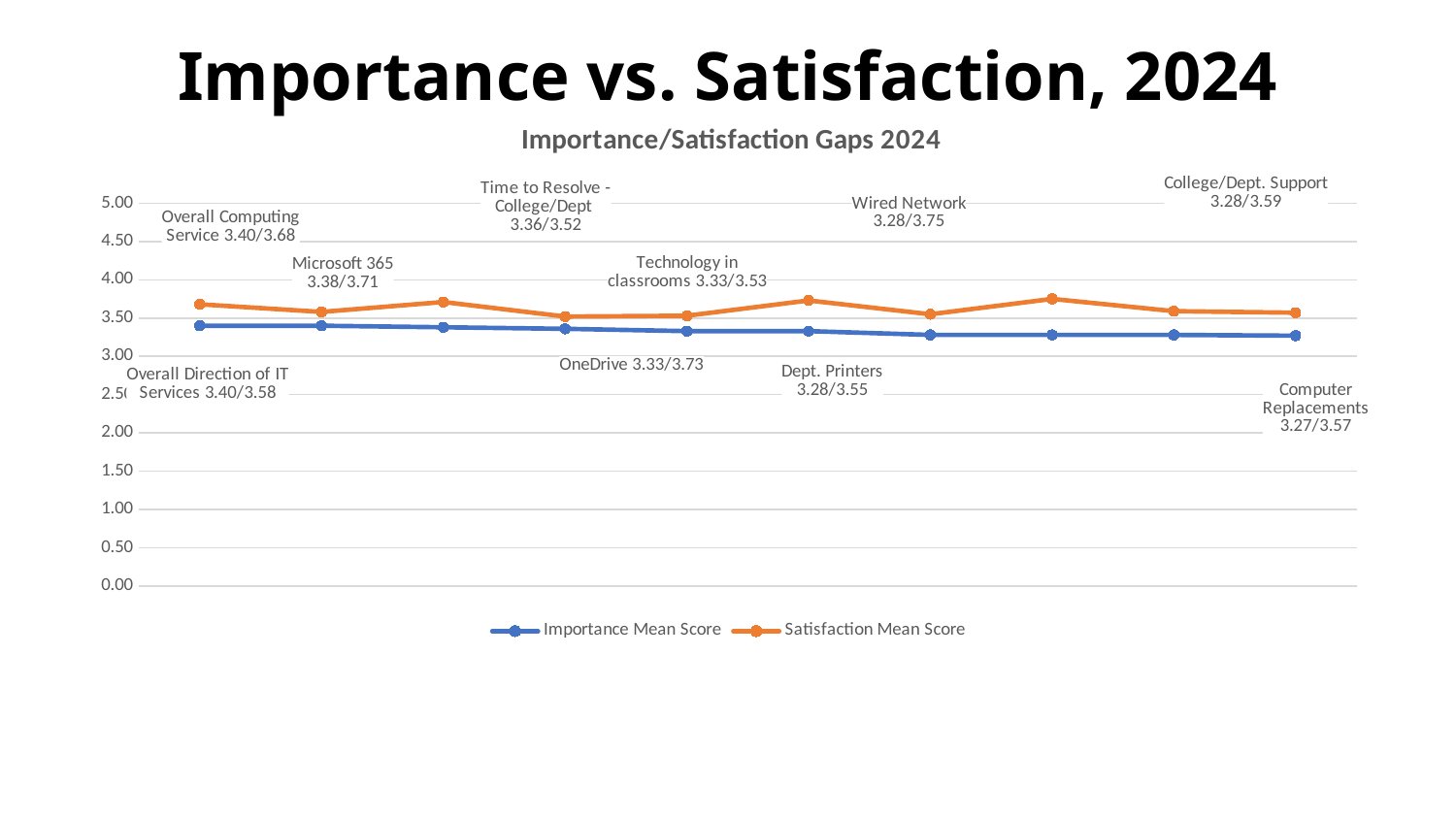
How many series does the legend list? 2 What is the Importance Mean Score for Overall Computing Service? 3.40 Does the Importance Mean Score generally rise or fall from left to right across the categories? fall Which category has the highest Satisfaction Mean Score? Wired Network What is the title of the chart? Importance/Satisfaction Gaps 2024 What kind of chart is shown on the slide? line chart How many categories are plotted on the chart? 10 What is the Satisfaction Mean Score for Wired Network? 3.75 Which is larger, the Satisfaction Mean Score for OneDrive or for Time to Resolve - College/Dept? OneDrive What is the Satisfaction Mean Score for Microsoft 365? 3.71 Which category has the lowest Importance Mean Score? Computer Replacements What is the difference between the Satisfaction Mean Score and the Importance Mean Score for Wired Network? 0.47